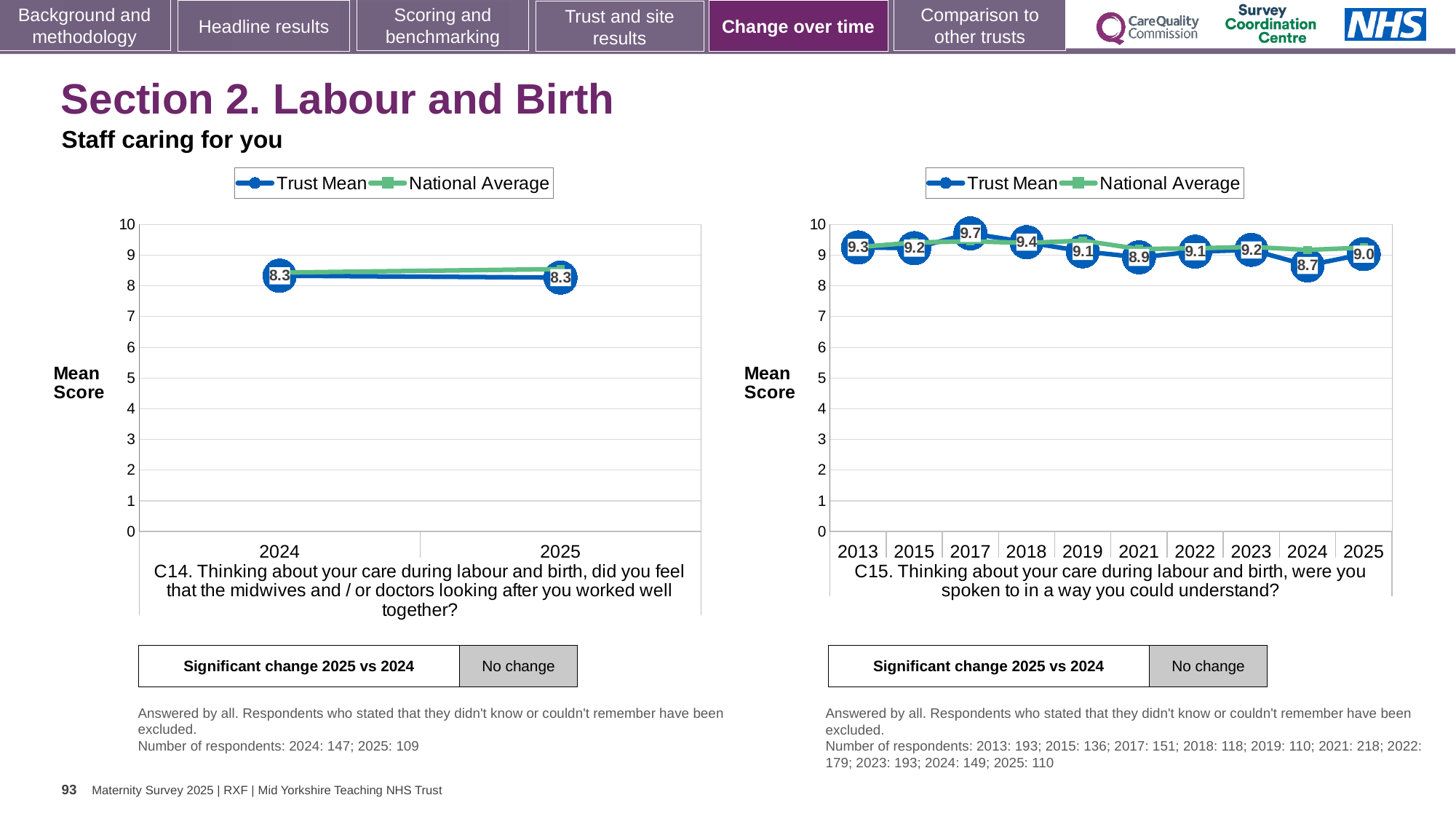
How many years are plotted on the x axis of the C15 chart on the right? 10 What kind of chart is the C14 chart on the left? Line chart In the C15 chart on the right, which year has the highest Trust Mean score? 2017 In the C14 chart on the left, what is the Trust Mean score for 2025? 8.3 In the C15 chart on the right, what is the difference between the Trust Mean scores for 2017 and 2024? 1.0 In the C15 chart on the right, what is the Trust Mean score for 2024? 8.7 In the C15 chart on the right, what is the Trust Mean score for 2017? 9.7 In the C14 chart on the left, what is the Trust Mean score for 2024? 8.3 In the C15 chart on the right, which year has the lowest Trust Mean score? 2024 How many series does the legend of the C15 chart on the right list? 2 In the C14 chart on the left, is the National Average value for 2025 greater or less than 8? greater In the C15 chart on the right, is the Trust Mean score higher in 2017 or in 2021? 2017